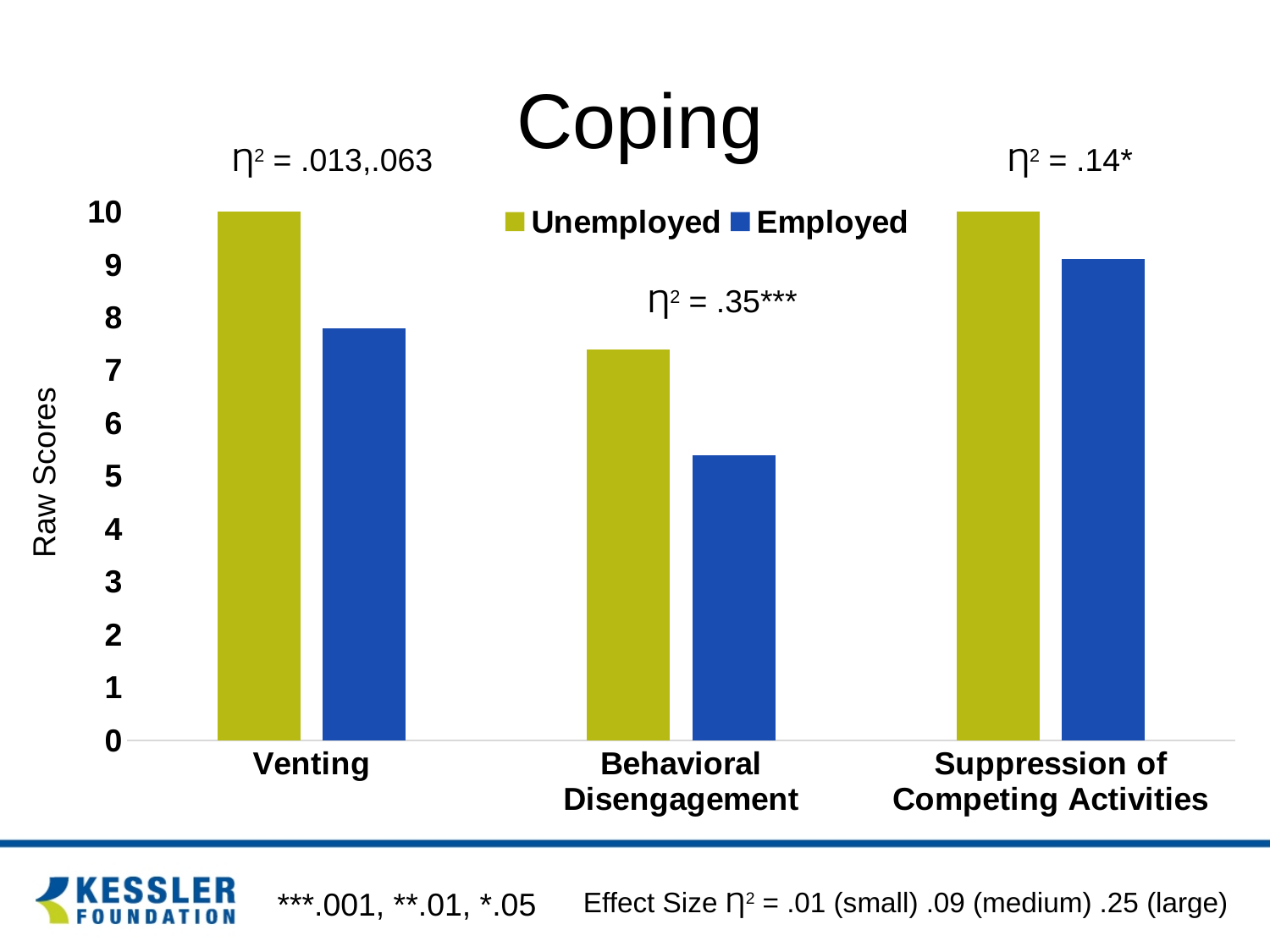
Which category has the lowest Employed value? Behavioral Disengagement What is the title of the chart? Coping For Behavioral Disengagement, which is larger, the Unemployed value or the Employed value? Unemployed What kind of chart is shown on the slide? bar chart How many categories are shown on the x axis? 3 How many series does the legend list? 2 Is the Employed value for Behavioral Disengagement greater or less than 5? greater Is the Unemployed value for Behavioral Disengagement greater or less than 8? less